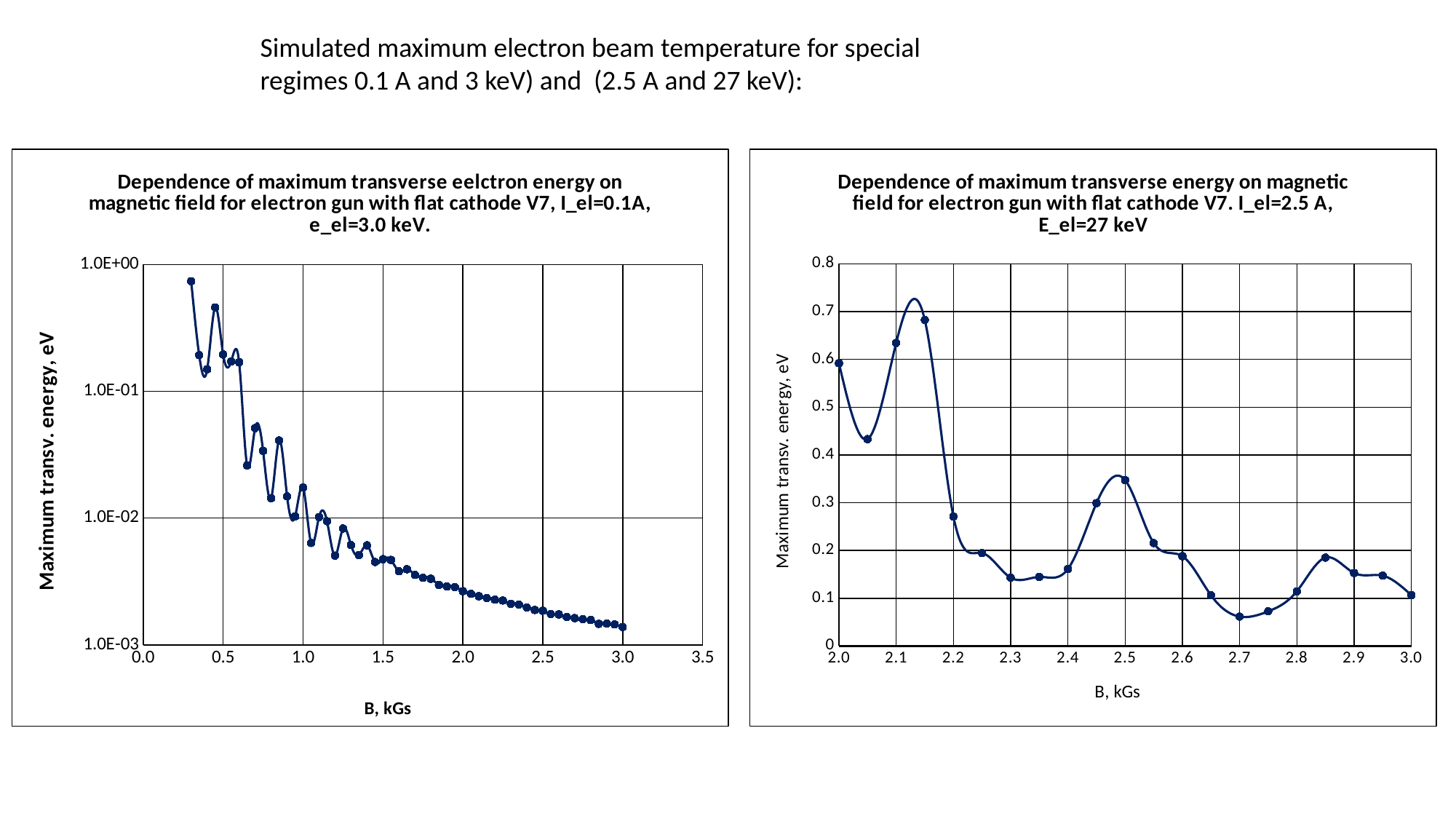
In the left chart (I_el=0.1A), is the value at B = 3.0 kGs greater or less than 1.0E-02 eV? less In the right chart (I_el=2.5 A), is the value at B = 2.3 kGs greater or less than 0.2 eV? less In the right chart (I_el=2.5 A), at which value of B is the maximum transverse energy lowest? 2.7 What kind of chart is the left chart (I_el=0.1A, e_el=3.0 keV)? line chart In the left chart (I_el=0.1A), is the value at the first point (B ≈ 0.3 kGs) greater or less than 1.0E-01 eV? greater In the right chart (I_el=2.5 A), which has the larger value: B = 2.5 kGs or B = 2.8 kGs? 2.5 kGs What is the x-axis label of the right chart (I_el=2.5 A)? B, kGs How many data points are plotted in the right chart (I_el=2.5 A)? 21 What kind of chart is the right chart (I_el=2.5 A, E_el=27 keV)? line chart In the left chart (I_el=0.1A), do the values overall rise or fall as B increases from 0.3 to 3.0 kGs? fall